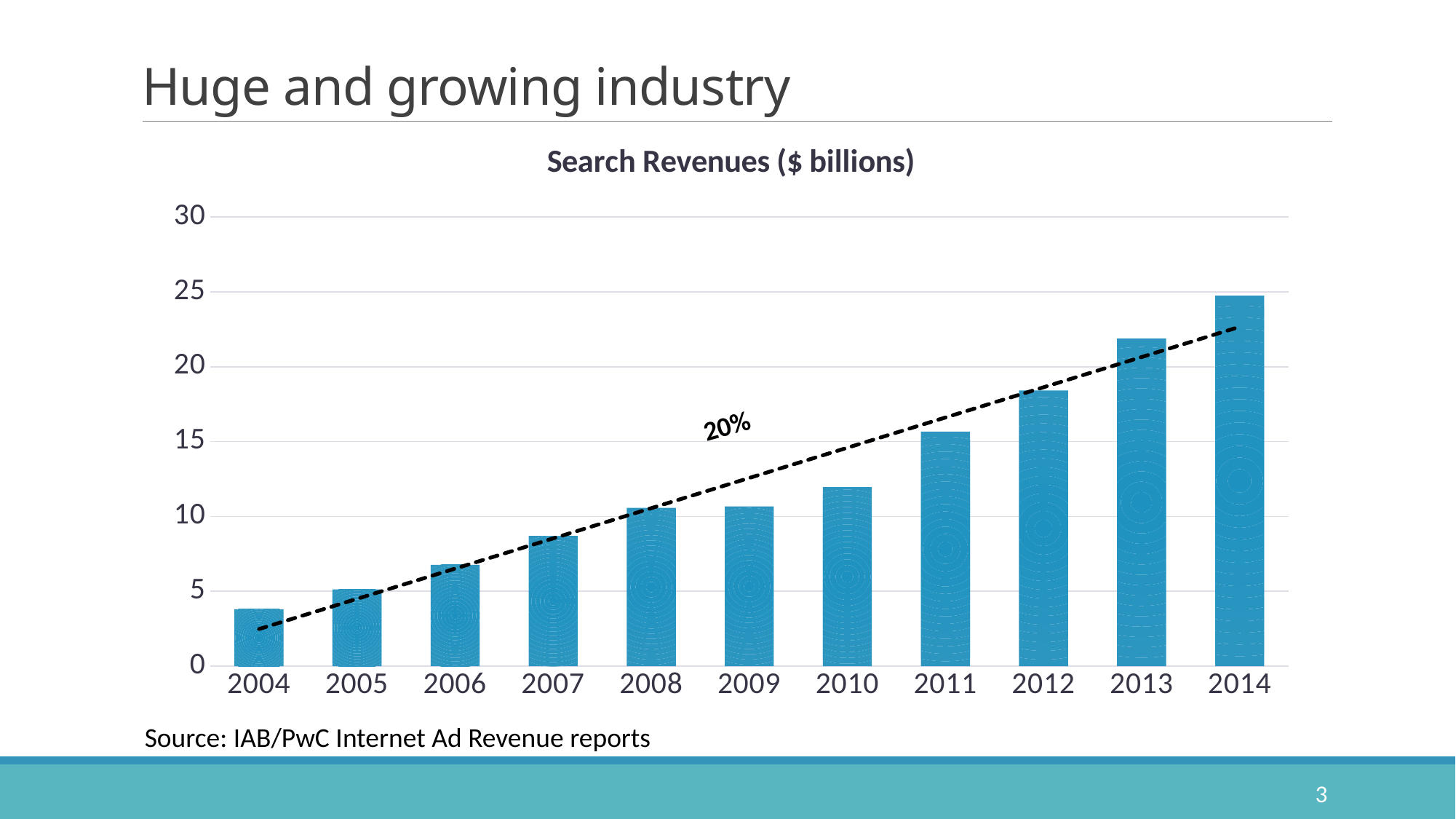
What is the title of the chart? Search Revenues ($ billions) What growth rate is labelled on the dashed trend line? 20% What kind of chart is shown on the slide? bar chart Do search revenues generally rise or fall from 2004 to 2014? rise Which is larger, the value for 2011 or the value for 2012? 2012 Is the value for 2014 greater or less than 20? greater Which year has the highest search revenue? 2014 Is the value for 2007 greater or less than 10? less Which year has the lowest search revenue? 2004 Is the value for 2004 greater or less than 5? less How many years are shown on the x axis of the chart? 11